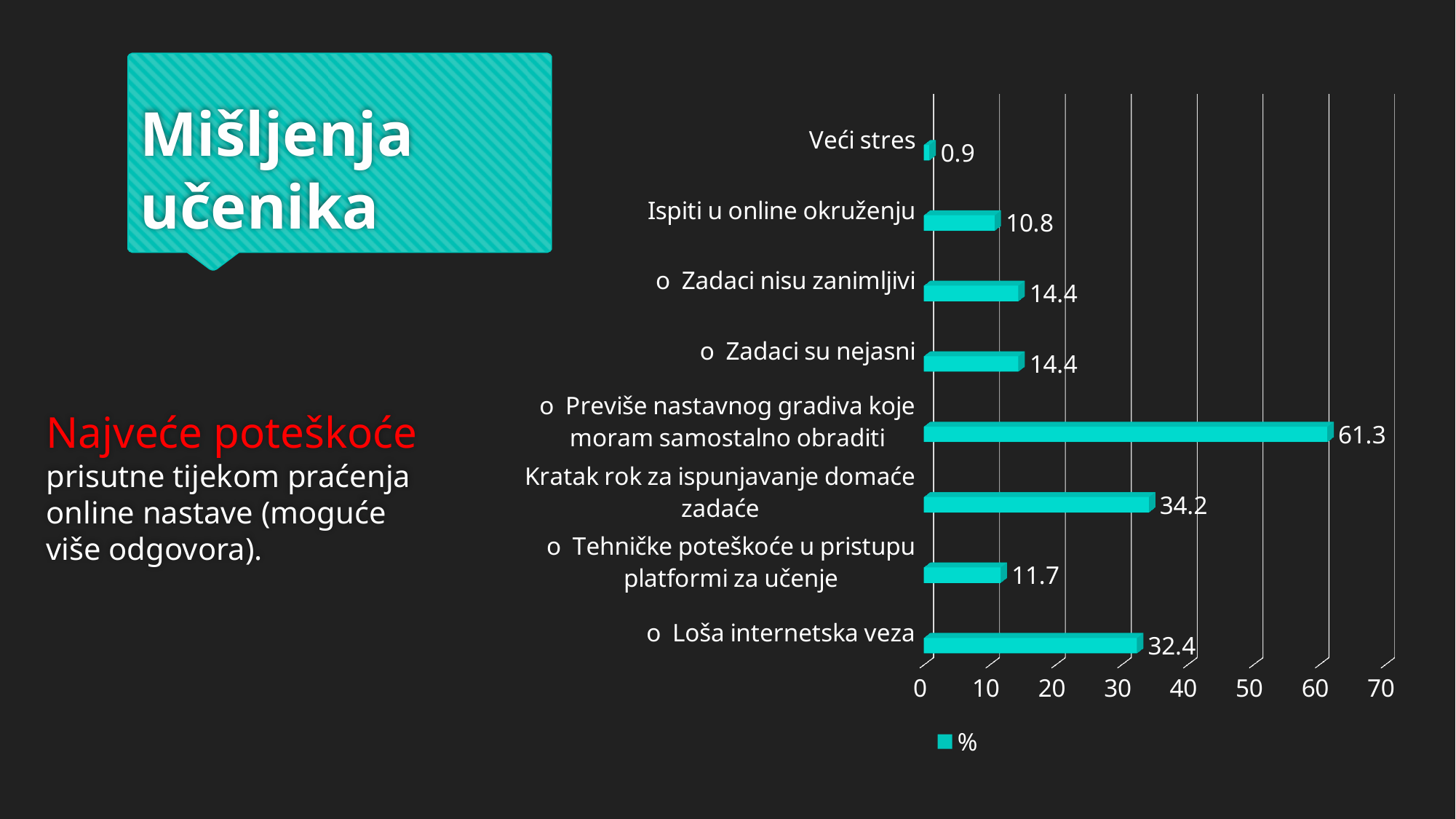
What is the legend entry for the series in the chart? % Which category has the highest value? Previše nastavnog gradiva koje moram samostalno obraditi Which is larger: the value for "Zadaci nisu zanimljivi" or the value for "Tehničke poteškoće u pristupu platformi za učenje"? Zadaci nisu zanimljivi How many series does the legend list? 1 Which category has the lowest value? Veći stres What value is shown for "Loša internetska veza"? 32.4 How many categories are shown in the chart? 8 What value is shown for "Tehničke poteškoće u pristupu platformi za učenje"? 11.7 What is the difference between the values for "Kratak rok za ispunjavanje domaće zadaće" and "Loša internetska veza"? 1.8 What value is shown for "Ispiti u online okruženju"? 10.8 What value is shown for "Previše nastavnog gradiva koje moram samostalno obraditi"? 61.3 What kind of chart is shown on the slide? Bar chart